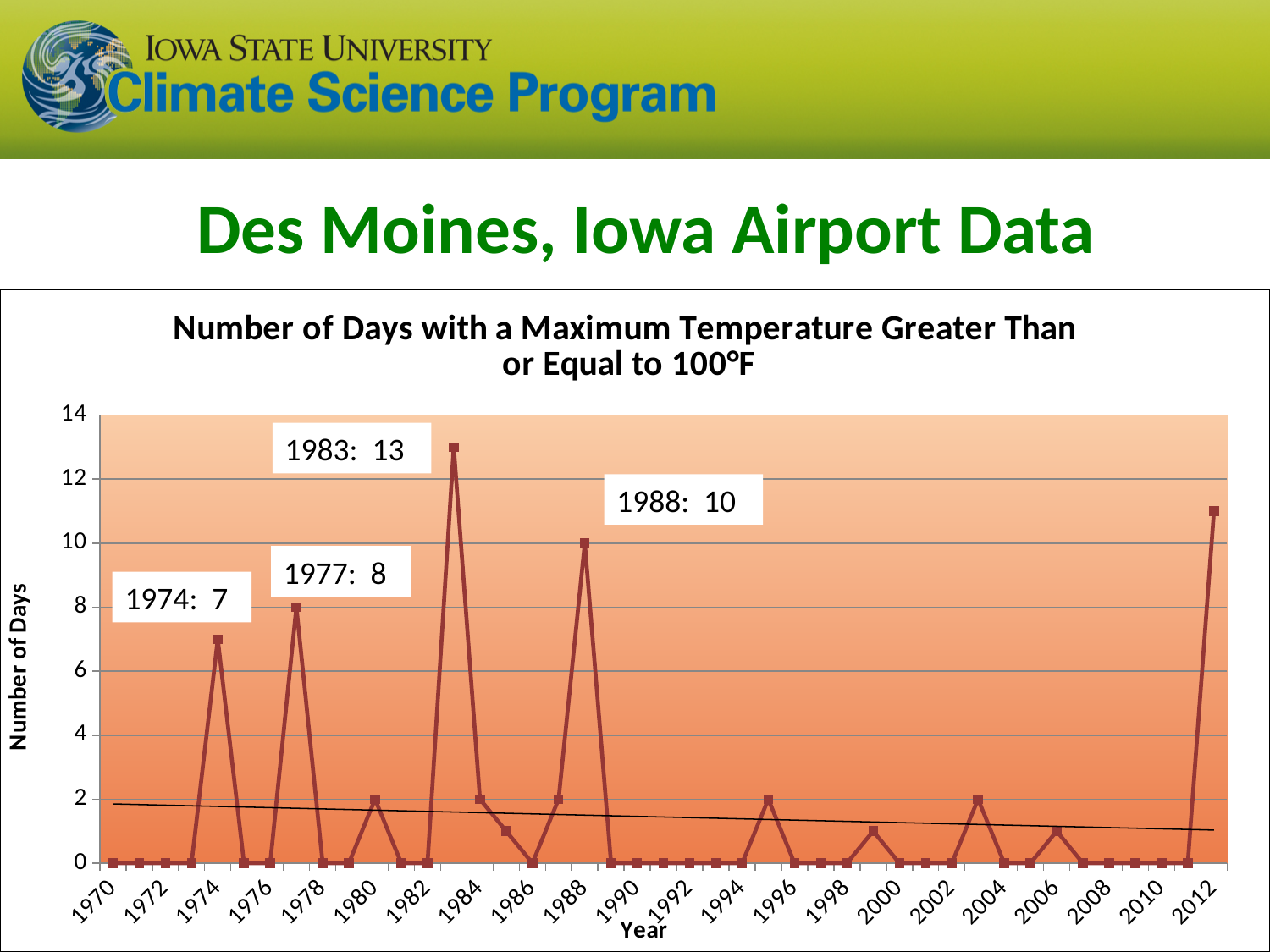
What is the value for 1988? 10 Which year has the larger value, 1974 or 1977? 1977 Is the value for 2012 greater or less than 10? greater What is the title of the vertical axis? Number of Days What is the value for 1977? 8 What is the difference between the values for 1977 and 1974? 1 What kind of chart is shown on the slide? line chart What is the value for 1974? 7 What is the difference between the values for 1983 and 1988? 3 How many days with a maximum temperature of 100°F or more were recorded in 1983? 13 Does the black trend line rise or fall from 1970 to 2012? fall Which year has the highest number of days with a maximum temperature of 100°F or more? 1983